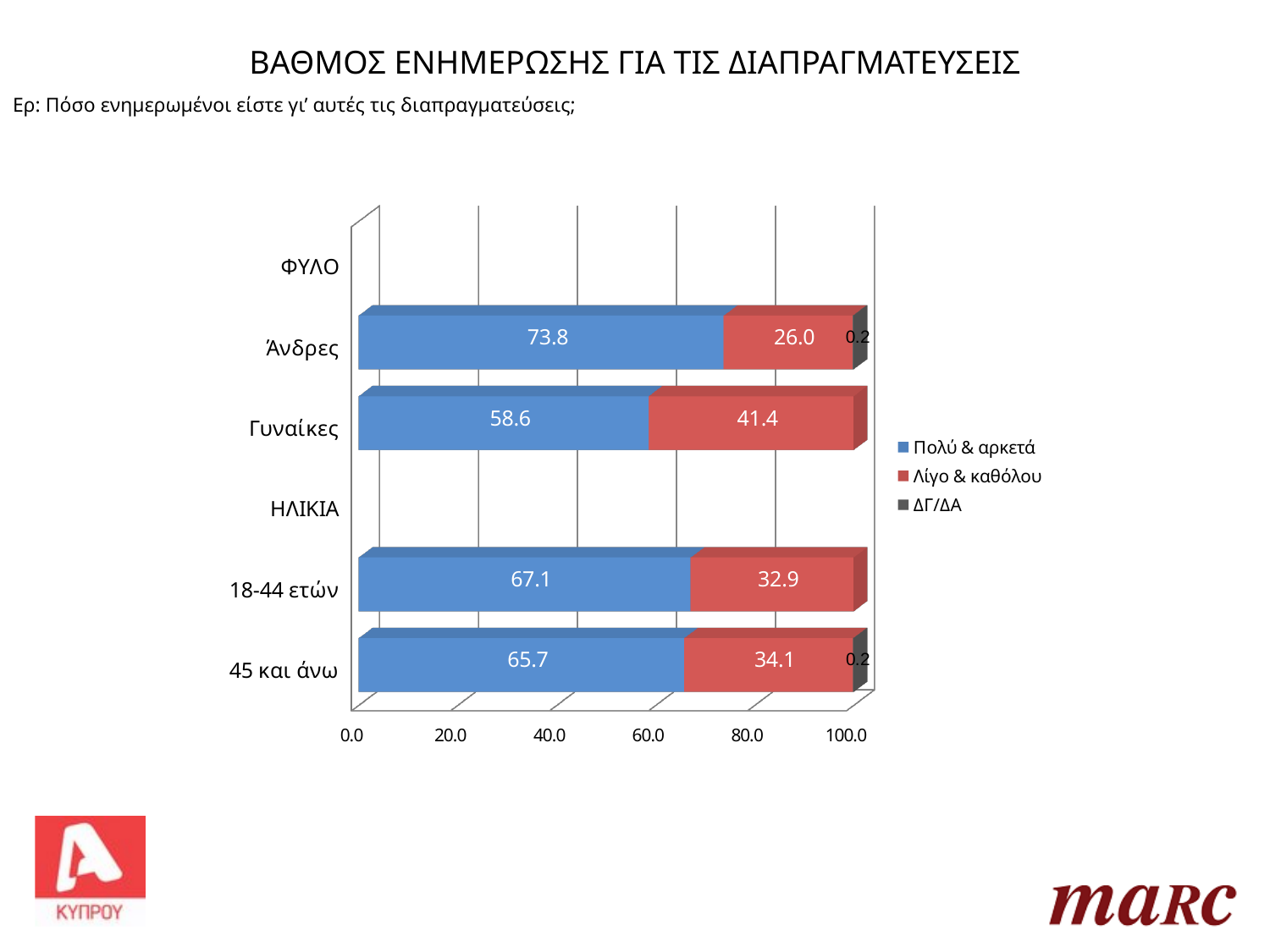
What is the difference between the 'Πολύ & αρκετά' values for Άνδρες and Γυναίκες? 15.2 What is the value of 'Πολύ & αρκετά' for 18-44 ετών? 67.1 What is the value of 'Πολύ & αρκετά' for Άνδρες? 73.8 Which colour represents the 'Λίγο & καθόλου' series? Red What is the total of the stacked bar for Άνδρες? 100.0 Which group has the highest value for 'Πολύ & αρκετά'? Άνδρες What kind of chart is shown on the slide? Stacked bar chart What is the value of 'ΔΓ/ΔΑ' for 45 και άνω? 0.2 How many series does the legend list? 3 Which is larger: the 'Λίγο & καθόλου' value for 18-44 ετών or for 45 και άνω? 45 και άνω What is the value of 'Λίγο & καθόλου' for Γυναίκες? 41.4 Which group has the lowest value for 'Πολύ & αρκετά'? Γυναίκες